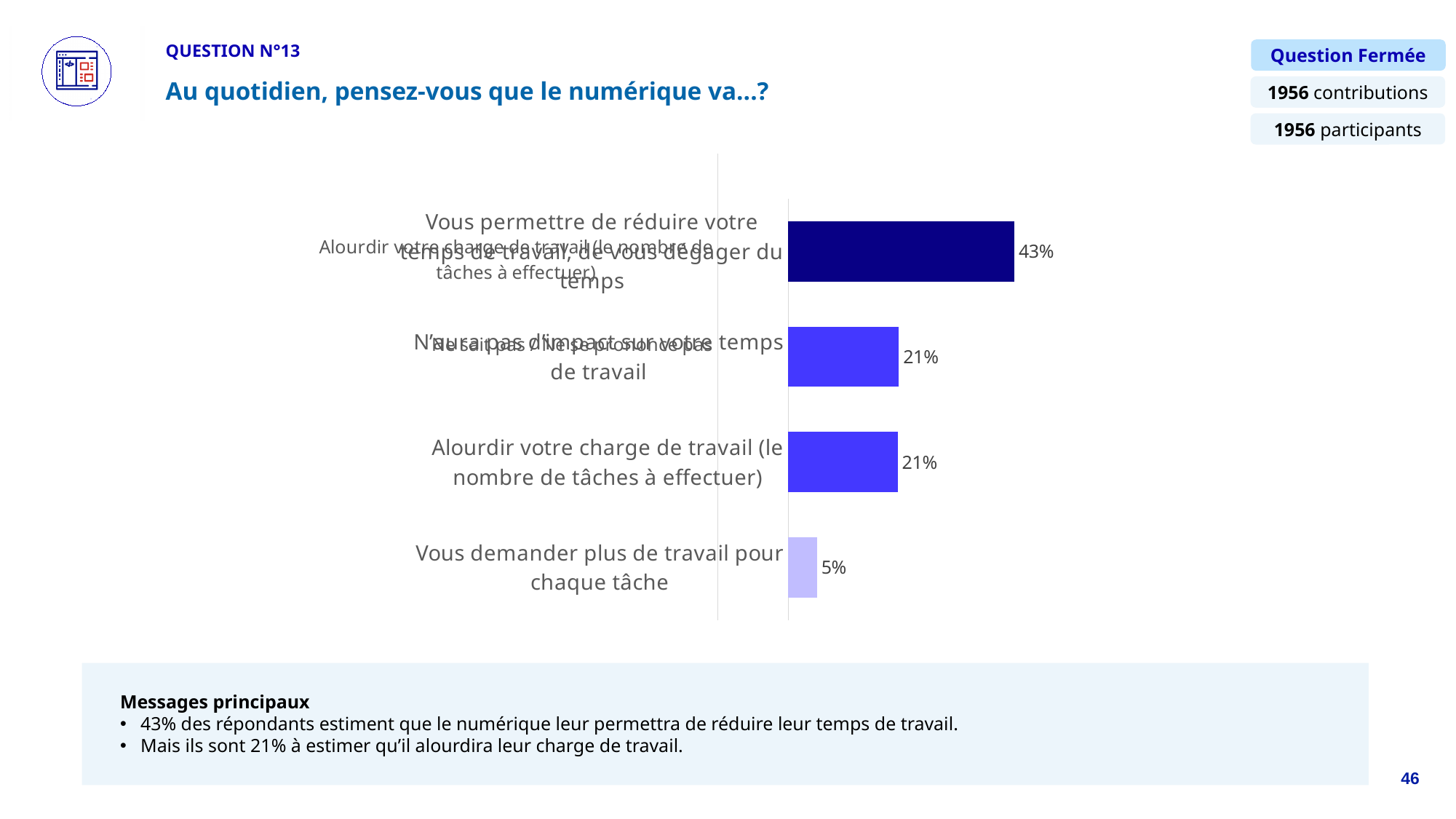
Which category has the highest value? Vous permettre de réduire votre temps de travail, de vous dégager du temps What is the difference between the value for "N'aura pas d'impact sur votre temps de travail" and the value for "Vous demander plus de travail pour chaque tâche"? 16% What is the value for "Alourdir votre charge de travail (le nombre de tâches à effectuer)"? 21% What is the difference between the value for "Vous permettre de réduire votre temps de travail, de vous dégager du temps" and the value for "Alourdir votre charge de travail (le nombre de tâches à effectuer)"? 22% Which is larger: the value for "Alourdir votre charge de travail (le nombre de tâches à effectuer)" or the value for "Vous demander plus de travail pour chaque tâche"? Alourdir votre charge de travail (le nombre de tâches à effectuer) What kind of chart is shown on the slide? bar chart How many categories does the chart show? 4 What is the question title shown above the chart? Au quotidien, pensez-vous que le numérique va…? What is the value for "N'aura pas d'impact sur votre temps de travail"? 21% What is the value for "Vous demander plus de travail pour chaque tâche"? 5% Which category has the lowest value? Vous demander plus de travail pour chaque tâche What is the value for "Vous permettre de réduire votre temps de travail, de vous dégager du temps"? 43%